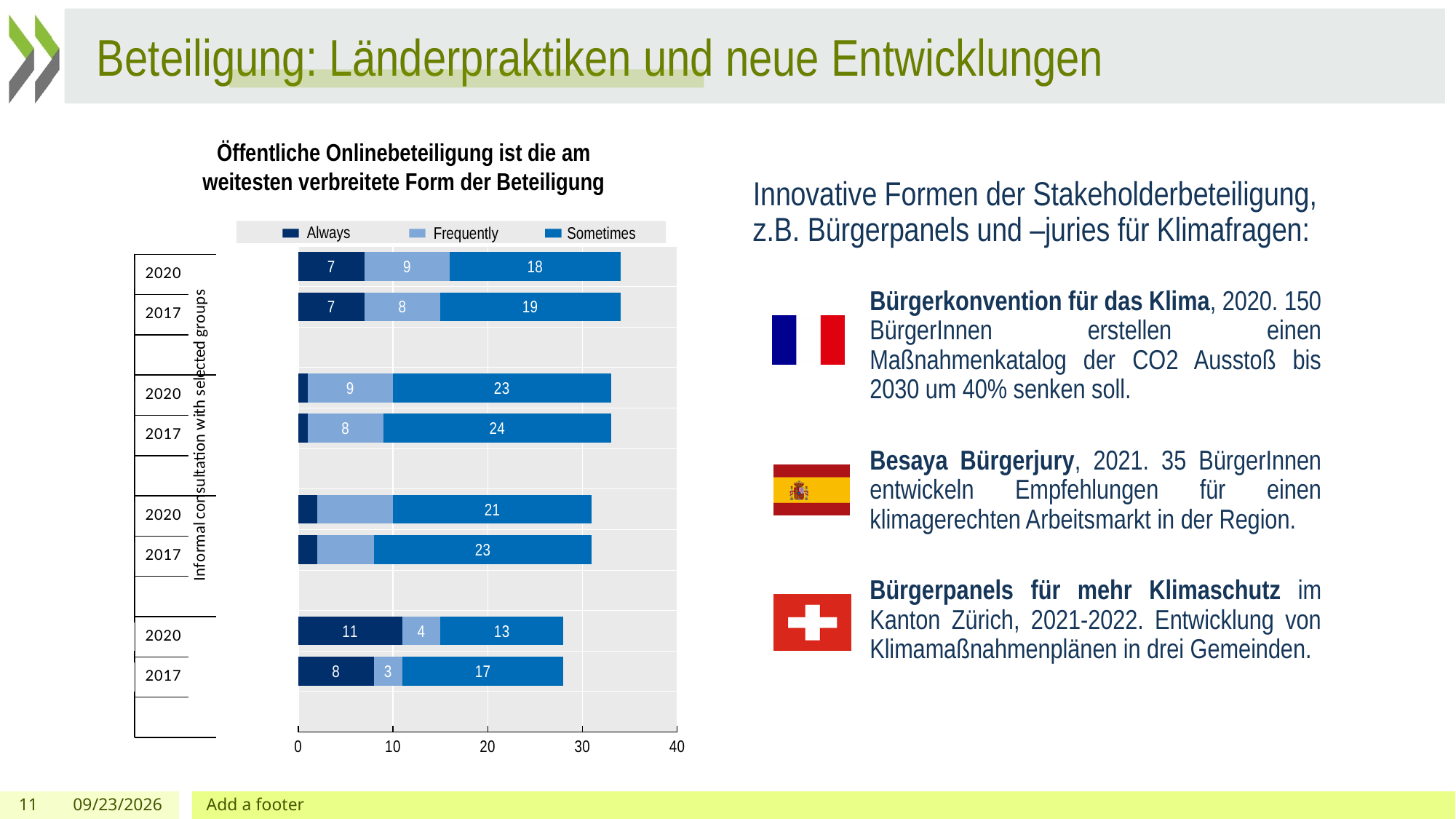
Is the total length of the bottom 2017 bar greater or less than 30? less What are the three series named in the chart legend? Always, Frequently, Sometimes In the bottom 2020 bar, what is the value of the Always segment? 11 In the bottom pair of bars, which year has the larger Always value, 2020 or 2017? 2020 In the topmost bar (2020), what is the value of the Sometimes segment? 18 How many series does the chart legend list? 3 In the bottom 2017 bar, what is the value of the Frequently segment? 3 What is the title of the chart? Öffentliche Onlinebeteiligung ist die am weitesten verbreitete Form der Beteiligung What is the total of the topmost bar (2020), summing Always, Frequently and Sometimes? 34 What is the total of the bottom 2020 bar, summing Always, Frequently and Sometimes? 28 What kind of chart is shown on the slide? bar chart In the bottom pair of bars, how much larger is the Sometimes value for 2017 than for 2020? 4